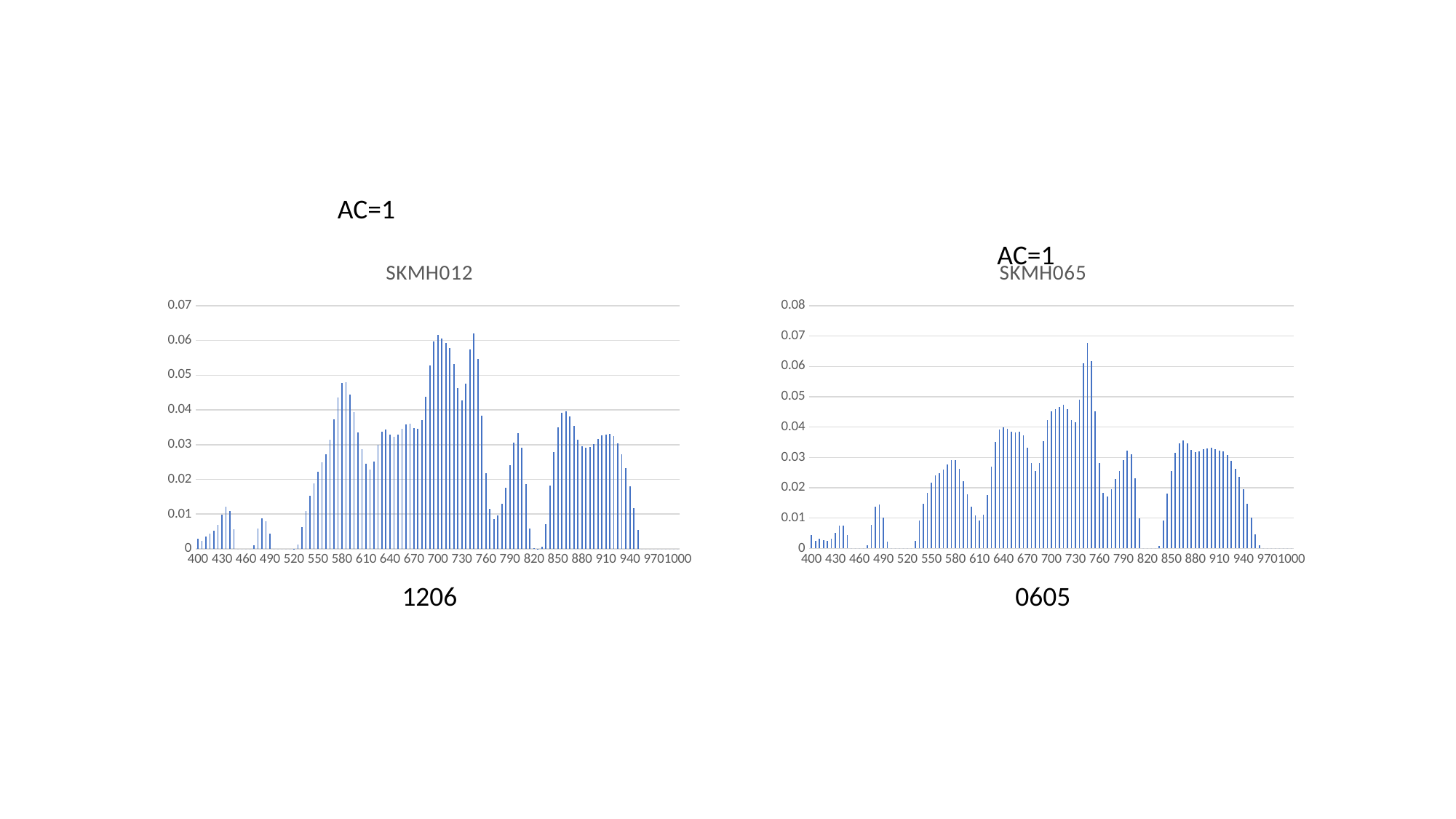
In the SKMH065 chart, which is larger, the value at 700 or the value at 580? 700 In the SKMH012 chart, is the value at 580 greater or less than 0.04? greater How many charts are shown on the slide? 2 In the SKMH065 chart, is the value at 580 greater or less than 0.04? less In the SKMH065 chart, is the highest bar greater or less than 0.06? greater In the SKMH012 chart, which is larger, the value at 700 or the value at 850? 700 What kind of chart is the SKMH012 chart on the left? bar chart In the SKMH012 chart, which is larger, the value at 580 or the value at 490? 580 What is the title of the chart on the right? SKMH065